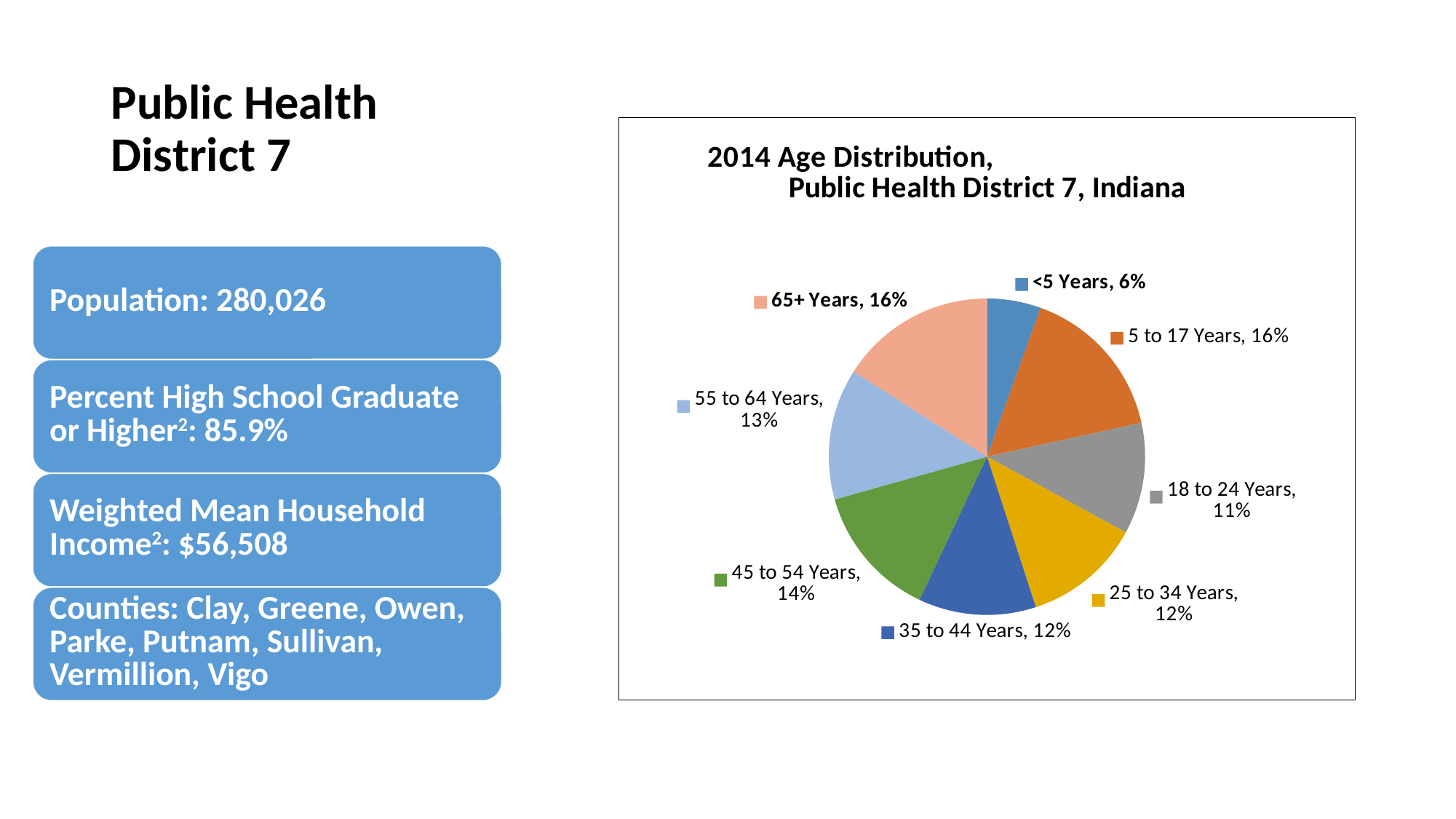
What percentage is shown for the 18 to 24 Years age group? 11% Which is larger, the 55 to 64 Years slice or the 35 to 44 Years slice? 55 to 64 Years What percentage is shown for the 55 to 64 Years age group? 13% What is the difference in percentage points between the 65+ Years slice and the <5 Years slice? 10 What is the difference in percentage points between the 45 to 54 Years slice and the 18 to 24 Years slice? 3 How many age groups are shown in the pie chart? 8 What type of chart is shown on the slide? Pie chart What share of the pie does the <5 Years slice represent? 6% Which age group has the smallest slice of the pie? <5 Years Which is larger, the 5 to 17 Years slice or the 25 to 34 Years slice? 5 to 17 Years What percentage is shown for the 45 to 54 Years age group? 14% What is the title of the chart? 2014 Age Distribution, Public Health District 7, Indiana